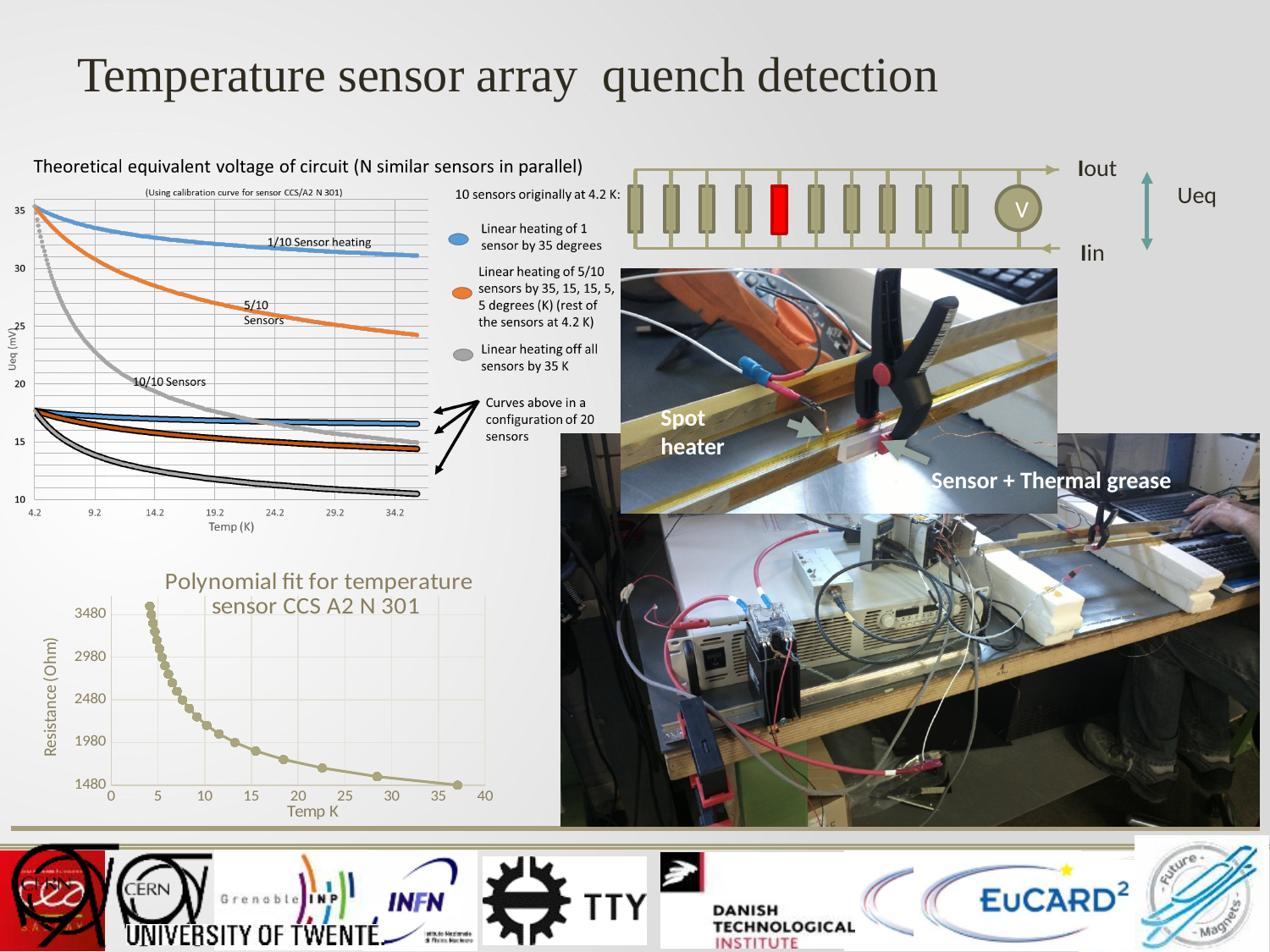
What type of chart is the bottom-left 'Polynomial fit for temperature sensor CCS A2 N 301' chart? scatter chart In the bottom-left 'Polynomial fit for temperature sensor CCS A2 N 301' chart, is the resistance at 35 K greater or less than 1980? less In the top-left 'Theoretical equivalent voltage of circuit' chart, is the value of the '10/10 Sensors' curve at 34.2 K greater or less than 20? less In the top-left 'Theoretical equivalent voltage of circuit' chart, is the value of the '5/10 Sensors' curve at 34.2 K greater or less than 30? less In the top-left 'Theoretical equivalent voltage of circuit' chart, how many heating scenarios does the legend list? 3 In the top-left 'Theoretical equivalent voltage of circuit' chart, does Ueq rise or fall as Temp (K) increases? fall What type of chart is the top-left chart titled 'Theoretical equivalent voltage of circuit'? line chart In the bottom-left 'Polynomial fit for temperature sensor CCS A2 N 301' chart, does Resistance rise or fall as Temp K increases? fall In the bottom-left 'Polynomial fit for temperature sensor CCS A2 N 301' chart, what is the label of the y axis? Resistance (Ohm) In the top-left 'Theoretical equivalent voltage of circuit' chart, at 34.2 K which curve is higher, '1/10 Sensor heating' or '10/10 Sensors'? 1/10 Sensor heating In the top-left 'Theoretical equivalent voltage of circuit' chart, what is the label of the y axis? Ueq (mV)